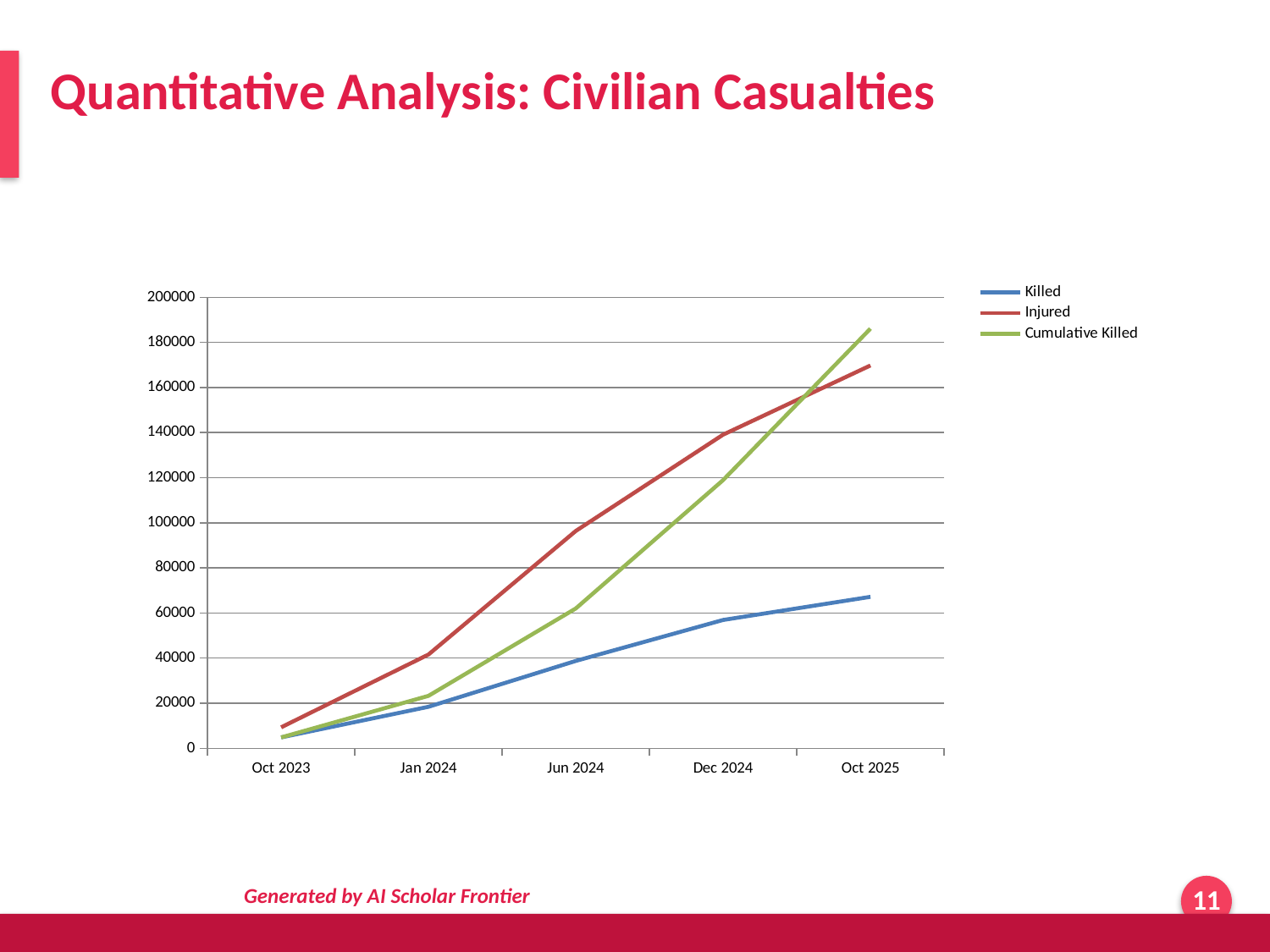
Is the value for Killed at Oct 2025 greater or less than 80000? less Is the value for Injured at Jun 2024 greater or less than 80000? greater What kind of chart is shown on the slide? line chart At Dec 2024, which is larger: Injured or Cumulative Killed? Injured Which series has the highest value at Oct 2025? Cumulative Killed How many series does the legend list? 3 How many time points are shown on the x axis? 5 Is the value for Injured at Oct 2025 greater or less than 160000? greater Which series has the lowest value at Oct 2025? Killed What colour is the Injured line in the legend? red Do the values for Killed rise or fall from Oct 2023 to Oct 2025? rise